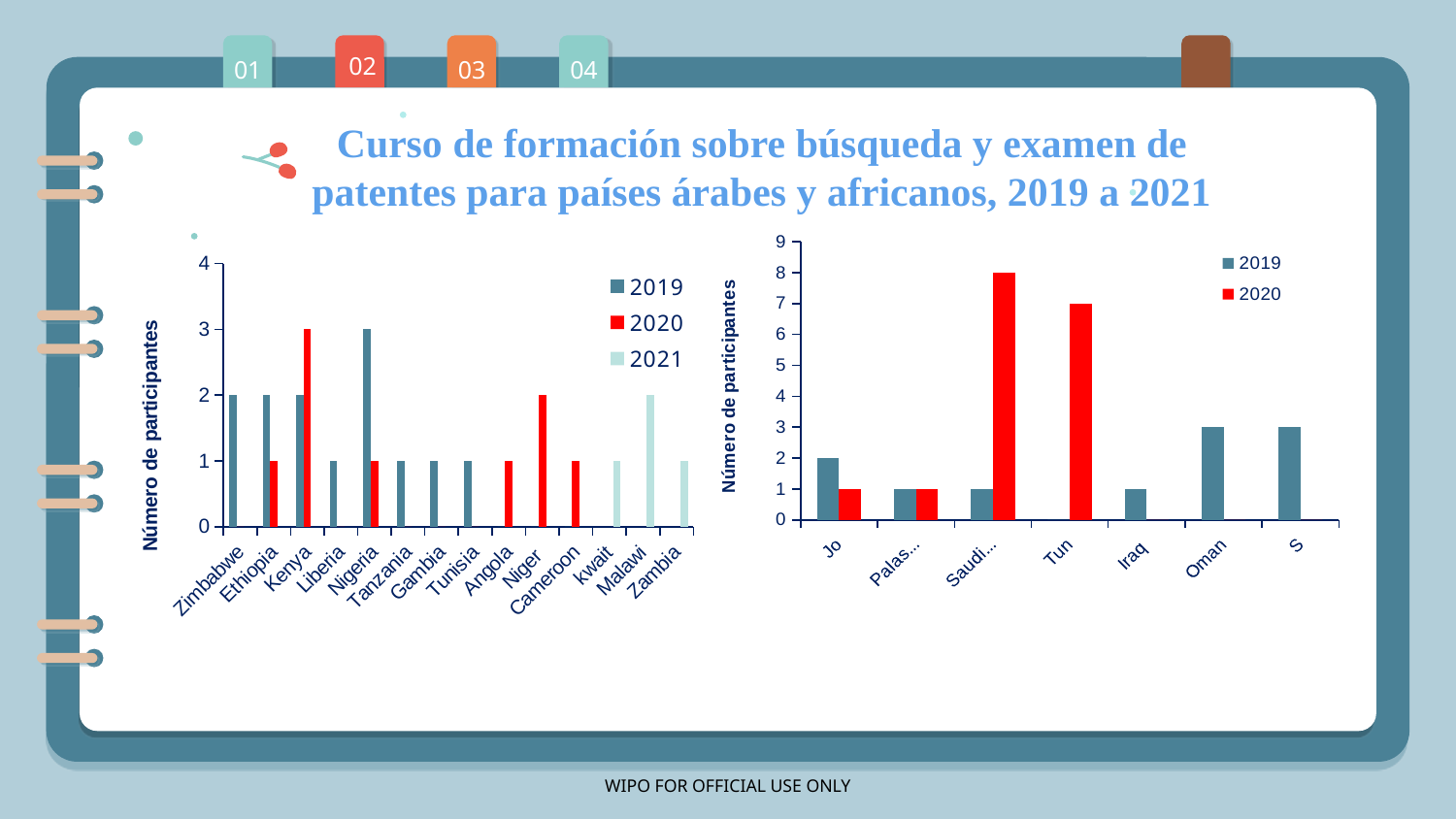
On the left chart, how many countries are shown on the x axis? 14 On the right chart, which is larger: the 2019 value for Oman or the 2019 value for Iraq? Oman On the right chart, how many categories are shown on the x axis? 7 On the left chart, what is the 2021 value for Malawi? 2 On the right chart, what is the difference between the 2020 value for Saudi... and the 2020 value for Jo? 7 On the left chart, what is the 2019 value for Nigeria? 3 What kind of chart is the left chart? Bar chart On the left chart, what is the 2020 value for Kenya? 3 On the right chart, what is the 2020 value for Tun? 7 On the left chart, how many series does the legend list? 3 On the right chart, which category has the highest 2020 value? Saudi... On the right chart, how many series does the legend list? 2